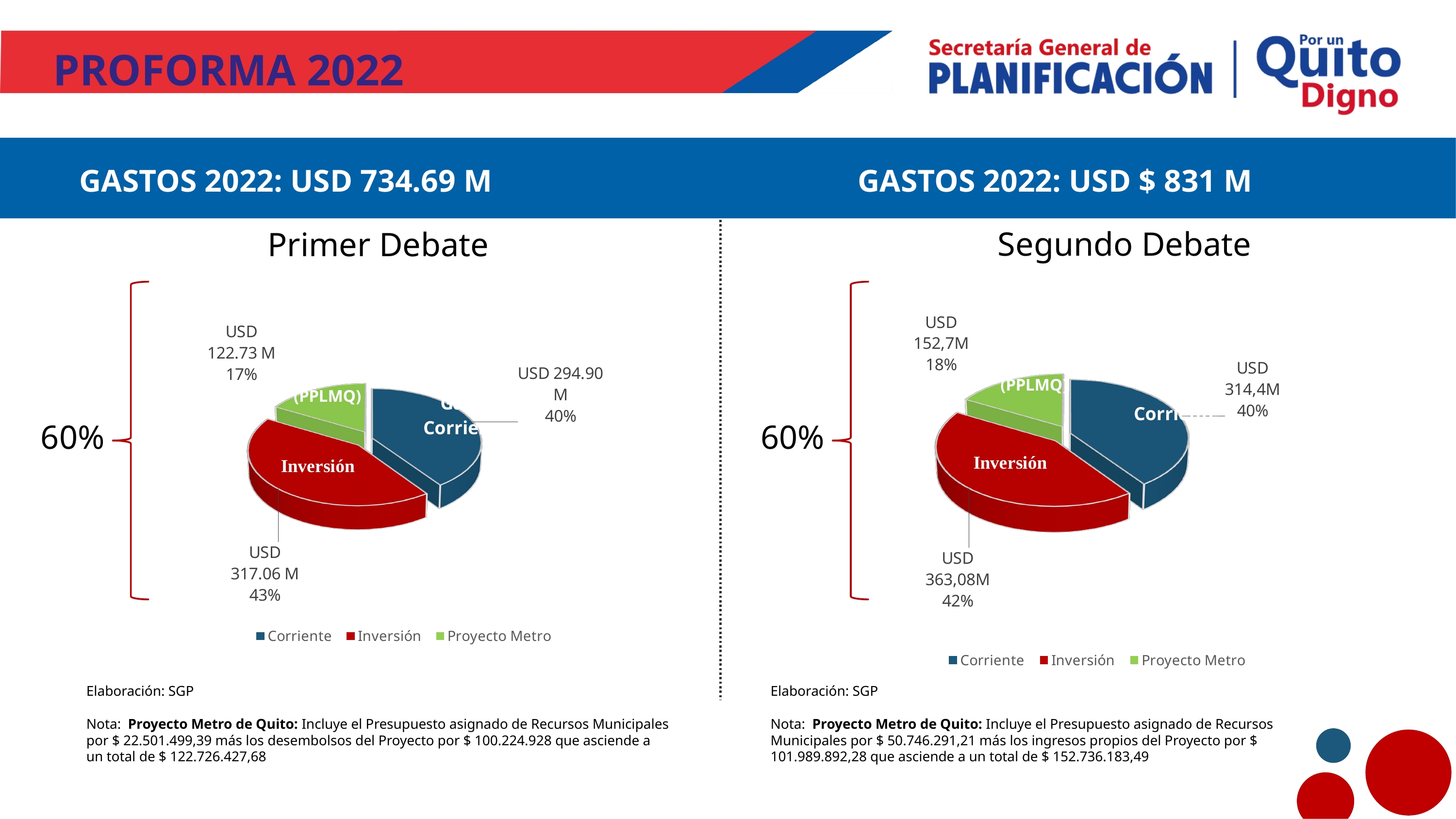
In the Primer Debate pie chart, what value is shown for Inversión? USD 317.06 M In the Primer Debate pie chart, what percentage share does Proyecto Metro (PPLMQ) have? 17% In the Primer Debate pie chart, what value is shown for Corriente? USD 294.90 M In the Segundo Debate pie chart, what value is shown for Proyecto Metro (PPLMQ)? USD 152,7M In the Segundo Debate pie chart, what value is shown for Inversión? USD 363,08M What type of chart is used for the Segundo Debate? Pie chart How many categories does the legend of the Primer Debate chart list? 3 In the Primer Debate pie chart, which category has the largest share? Inversión In the Segundo Debate pie chart, which category has the smallest share? Proyecto Metro In the Segundo Debate pie chart, what is the difference in percentage points between the Inversión share and the Corriente share? 2 percentage points In the Segundo Debate pie chart, what percentage share does Corriente have? 40% In the Primer Debate pie chart, which is larger, the share for Corriente or the share for Proyecto Metro? Corriente